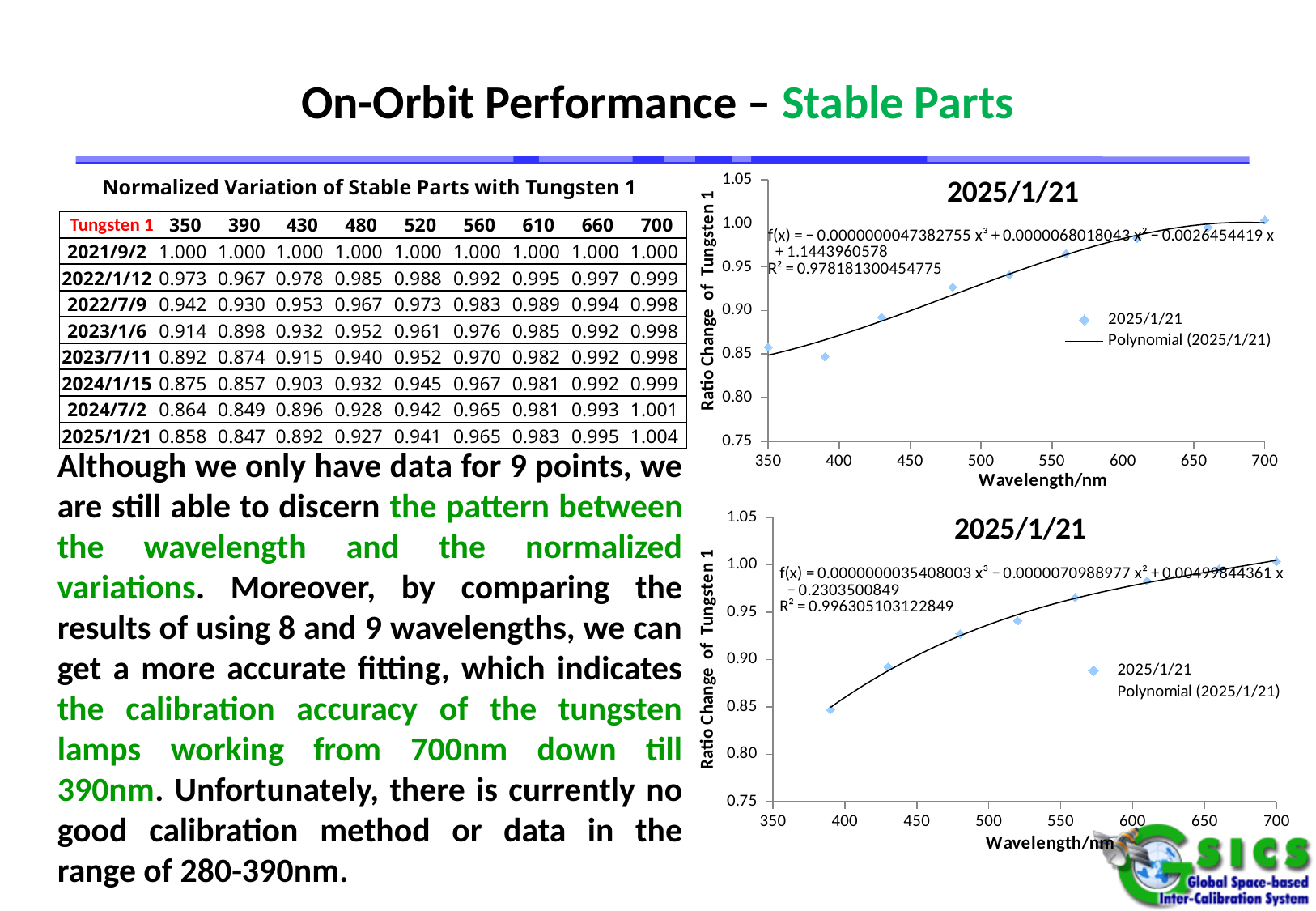
How many data points are plotted in the bottom chart titled 2025/1/21? 8 In the bottom chart, at which wavelength is the plotted value lowest? 390 In the top chart, is the value at 480 nm greater or less than 0.95? less What R² value is shown on the bottom chart? 0.996305103122849 How many data points are plotted in the top chart titled 2025/1/21? 9 What kind of chart is the top chart on the right side of the slide? Scatter chart with a polynomial trendline How many entries does the legend of the top chart list? 2 In the bottom chart, do the values rise or fall as wavelength increases from 390 nm to 700 nm? rise In the top chart, is the value at 350 nm greater or less than 0.90? less What is the x-axis title of the top chart? Wavelength/nm In the top chart, is the value at 560 nm greater or less than 0.95? greater In the bottom chart, at which wavelength is the plotted value highest? 700